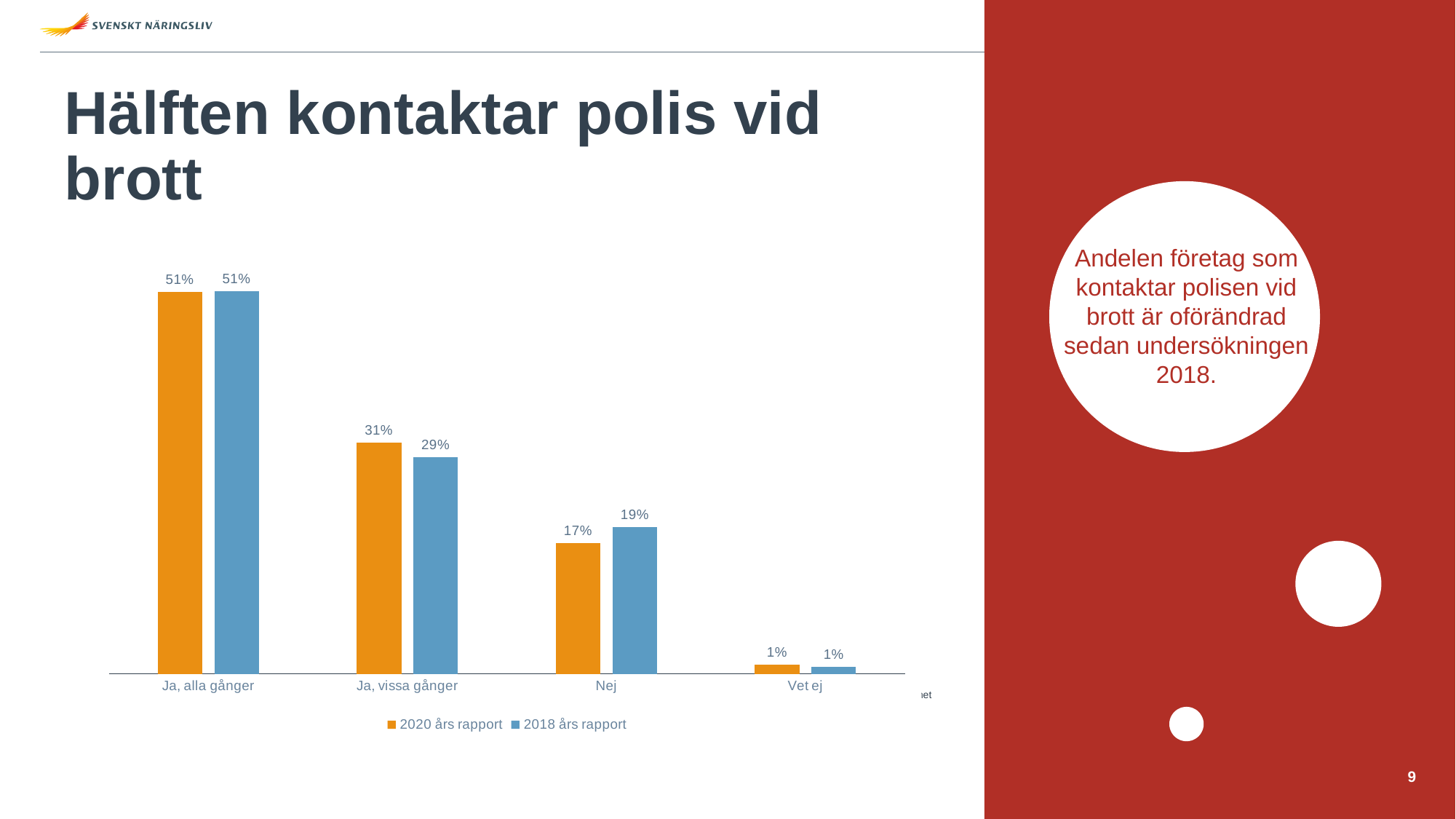
What is the value for "Nej" in the 2020 års rapport series? 17% What is the value for "Vet ej" in the 2018 års rapport series? 1% Which category has the lowest value in the 2018 års rapport series? Vet ej For "Nej", which series has the larger value, 2020 års rapport or 2018 års rapport? 2018 års rapport Which colour represents the 2018 års rapport series in the chart? Blue What is the value for "Ja, alla gånger" in the 2020 års rapport series? 51% Which category has the highest value in the 2020 års rapport series? Ja, alla gånger What is the difference between the 2020 års rapport and 2018 års rapport values for "Ja, vissa gånger"? 2% What kind of chart is shown on the slide? Bar chart How many categories are shown on the x axis of the chart? 4 How many series does the legend list? 2 What is the value for "Ja, vissa gånger" in the 2018 års rapport series? 29%